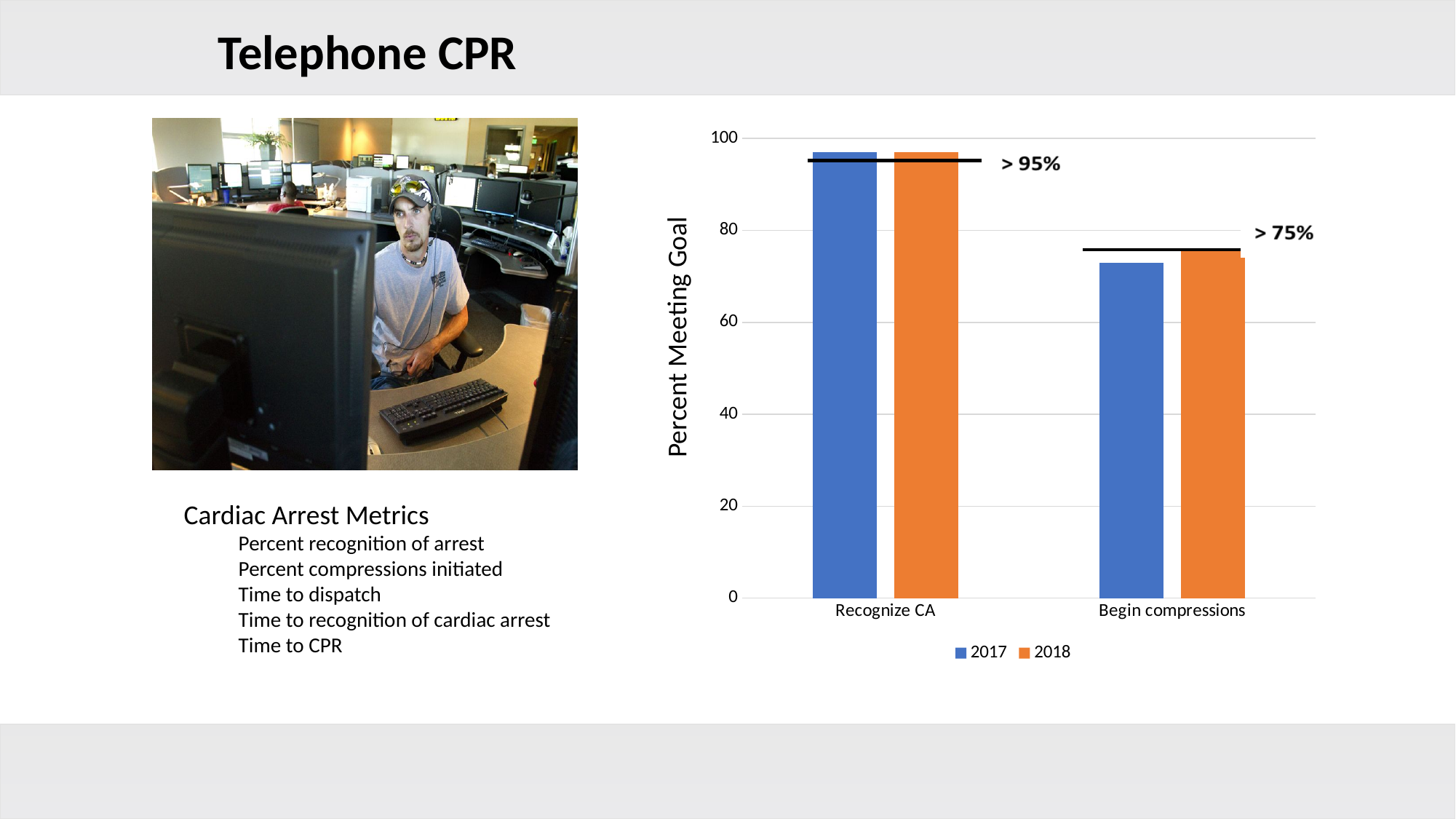
How many categories are shown on the x axis of the chart? 2 Is the 2017 value for Recognize CA greater or less than 80? greater Which category has the highest value for the 2018 series? Recognize CA Is the 2017 value for Begin compressions greater or less than 80? less Is the 2018 value for Recognize CA greater or less than 100? less What is the title of the chart's vertical axis? Percent Meeting Goal Which category has the lowest value for the 2018 series? Begin compressions How many series does the chart's legend list? 2 What kind of chart is shown on the slide? bar chart What goal label is shown above the Begin compressions bars? > 75% Which category has the higher value for 2017, Recognize CA or Begin compressions? Recognize CA